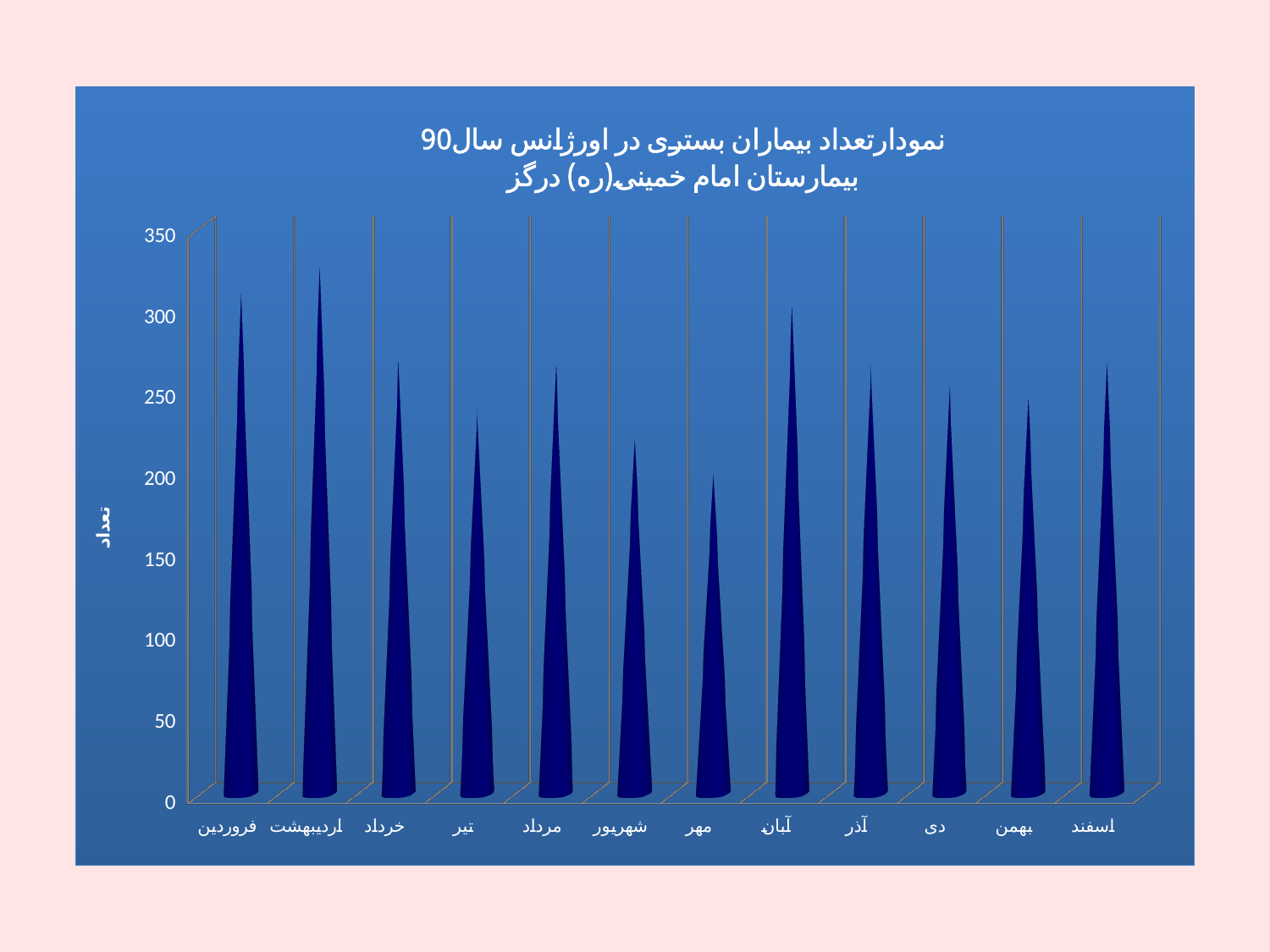
Is the value for مهر greater or less than 250? less Is the value for آبان greater or less than 250? greater Which month has the highest value? اردیبهشت Is the value for اردیبهشت greater or less than 300? greater What is the label on the vertical axis? تعداد What kind of chart is shown on the slide? bar chart Which is larger, the value for فروردین or the value for شهریور? فروردین Which is larger, the value for آبان or the value for تیر? آبان How many months (categories) are shown on the x axis? 12 Which month has the lowest value? مهر